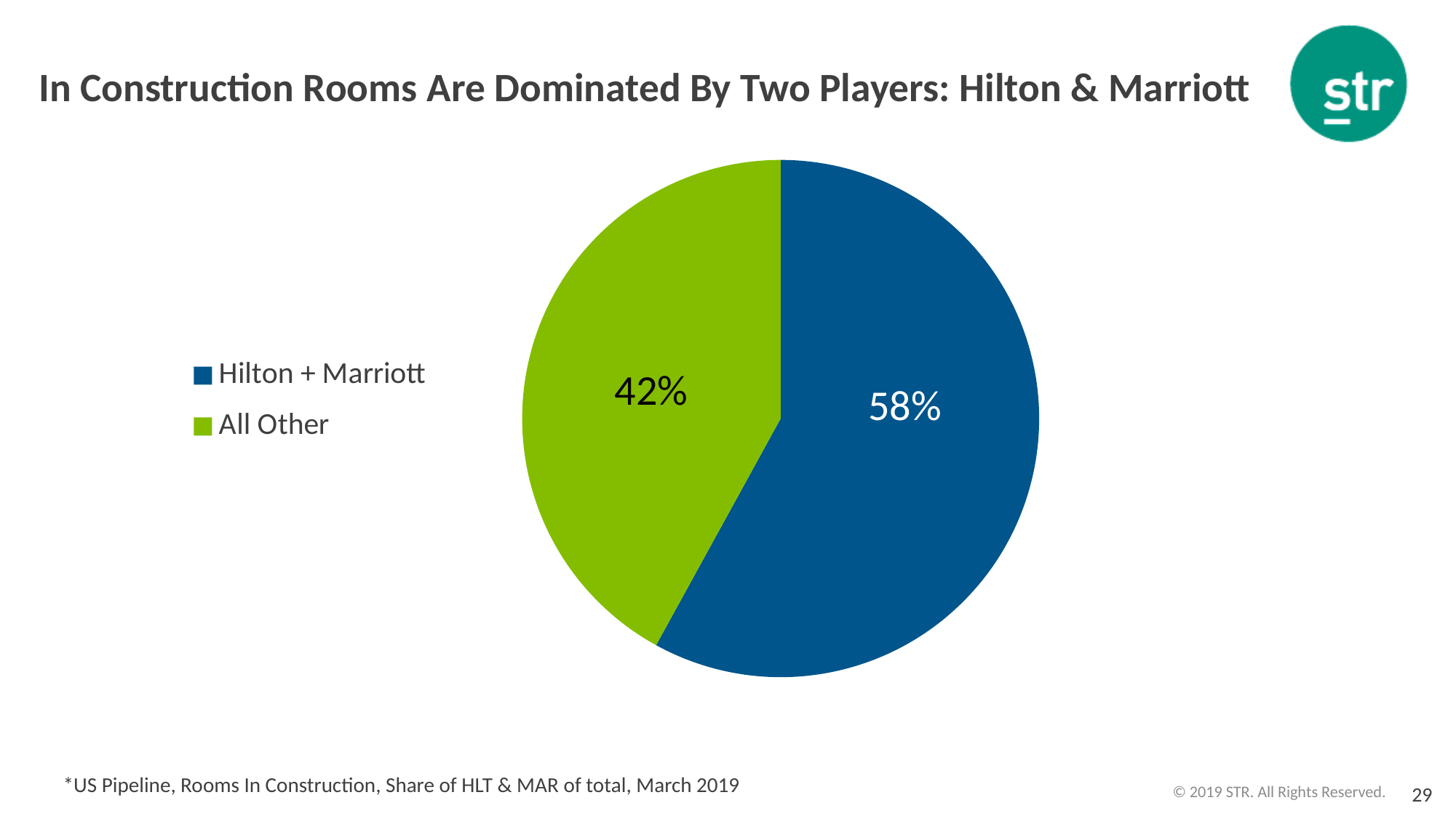
Is the share for Hilton + Marriott greater or less than 50%? greater How many slices does the pie chart have? 2 What colour is the Hilton + Marriott slice? Blue Which slice is the smallest? All Other Which is larger, the Hilton + Marriott slice or the All Other slice? Hilton + Marriott What colour is the All Other slice? Green What share of the pie does All Other hold? 42% What kind of chart is shown on the slide? Pie chart What share of the pie does Hilton + Marriott hold? 58% How many entries does the legend list? 2 What is the difference in percentage points between the Hilton + Marriott slice and the All Other slice? 16 percentage points Which slice is the largest? Hilton + Marriott